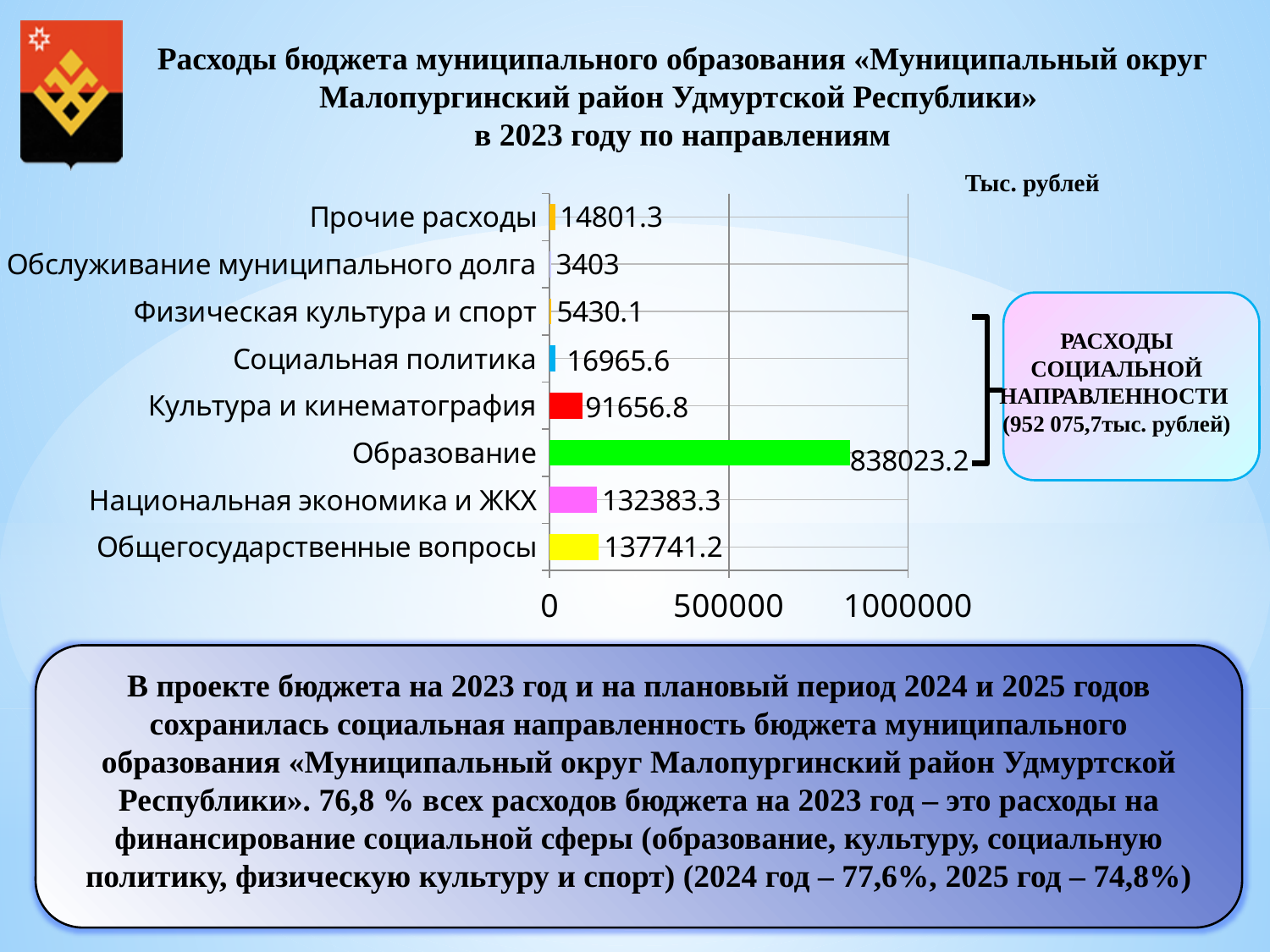
How many categories are shown in the chart? 8 Which category has the highest value? Образование What is the difference between Общегосударственные вопросы and Национальная экономика и ЖКХ? 5357.9 What is the value for Обслуживание муниципального долга? 3403 What is the value for Образование? 838023.2 Is the value for Образование greater or less than 500000? greater What is the value for Национальная экономика и ЖКХ? 132383.3 Which category has the lowest value? Обслуживание муниципального долга Which is larger, Социальная политика or Прочие расходы? Социальная политика What kind of chart is shown on the slide? bar chart What is the value for Культура и кинематография? 91656.8 What is the difference between Образование and Культура и кинематография? 746366.4